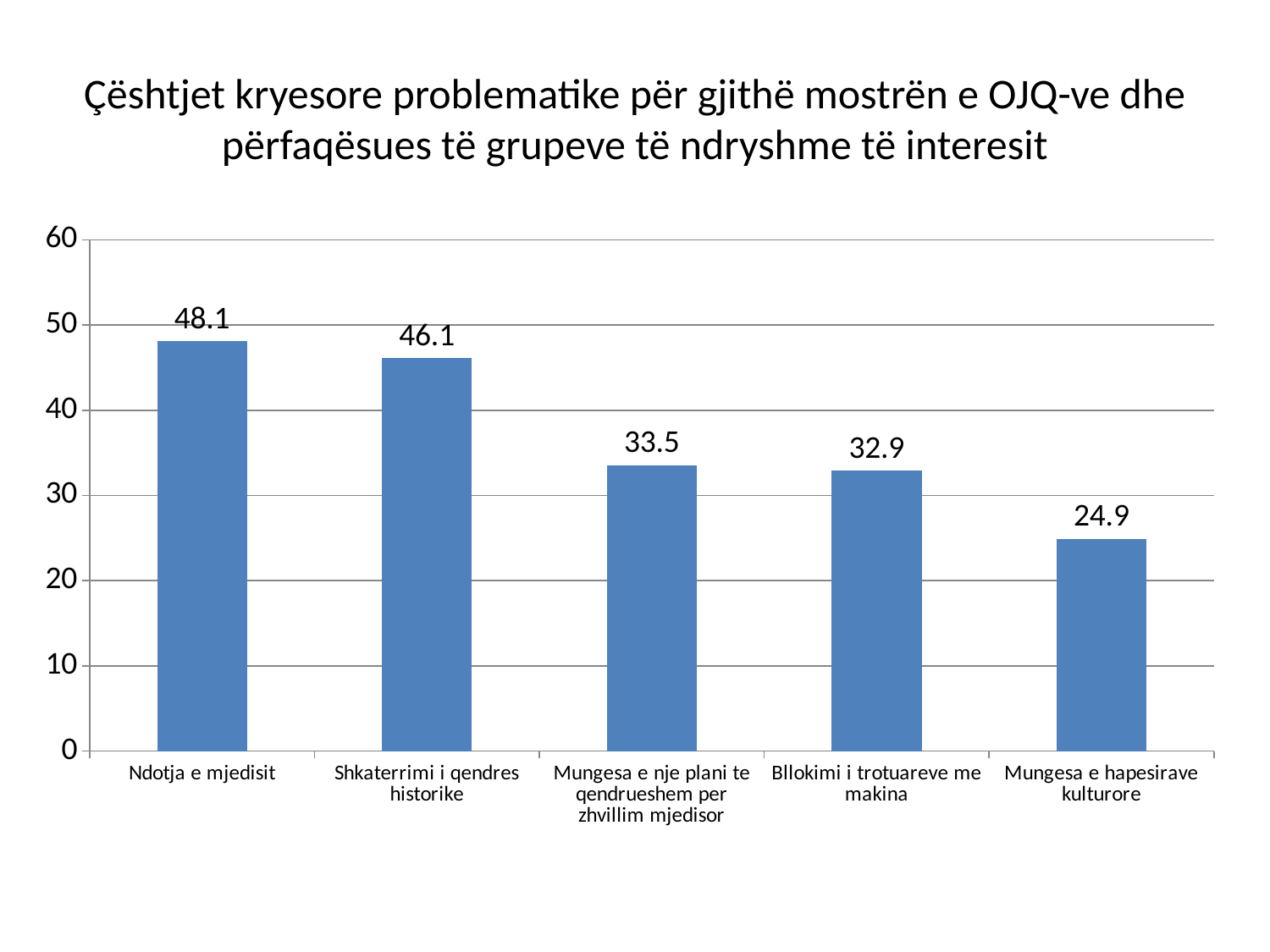
What is the difference between the values for Shkaterrimi i qendres historike and Mungesa e nje plani te qendrueshem per zhvillim mjedisor? 12.6 Do the values rise or fall from left to right along the x axis? Fall What is the difference between the values for Ndotja e mjedisit and Mungesa e hapesirave kulturore? 23.2 What is the value for Mungesa e hapesirave kulturore? 24.9 What is the value for Shkaterrimi i qendres historike? 46.1 What is the value for Ndotja e mjedisit? 48.1 What is the value for Mungesa e nje plani te qendrueshem per zhvillim mjedisor? 33.5 How many categories are shown in the chart? 5 Which category has the highest value? Ndotja e mjedisit What kind of chart is shown on the slide? Bar chart What is the value for Bllokimi i trotuareve me makina? 32.9 Which category has the lowest value? Mungesa e hapesirave kulturore